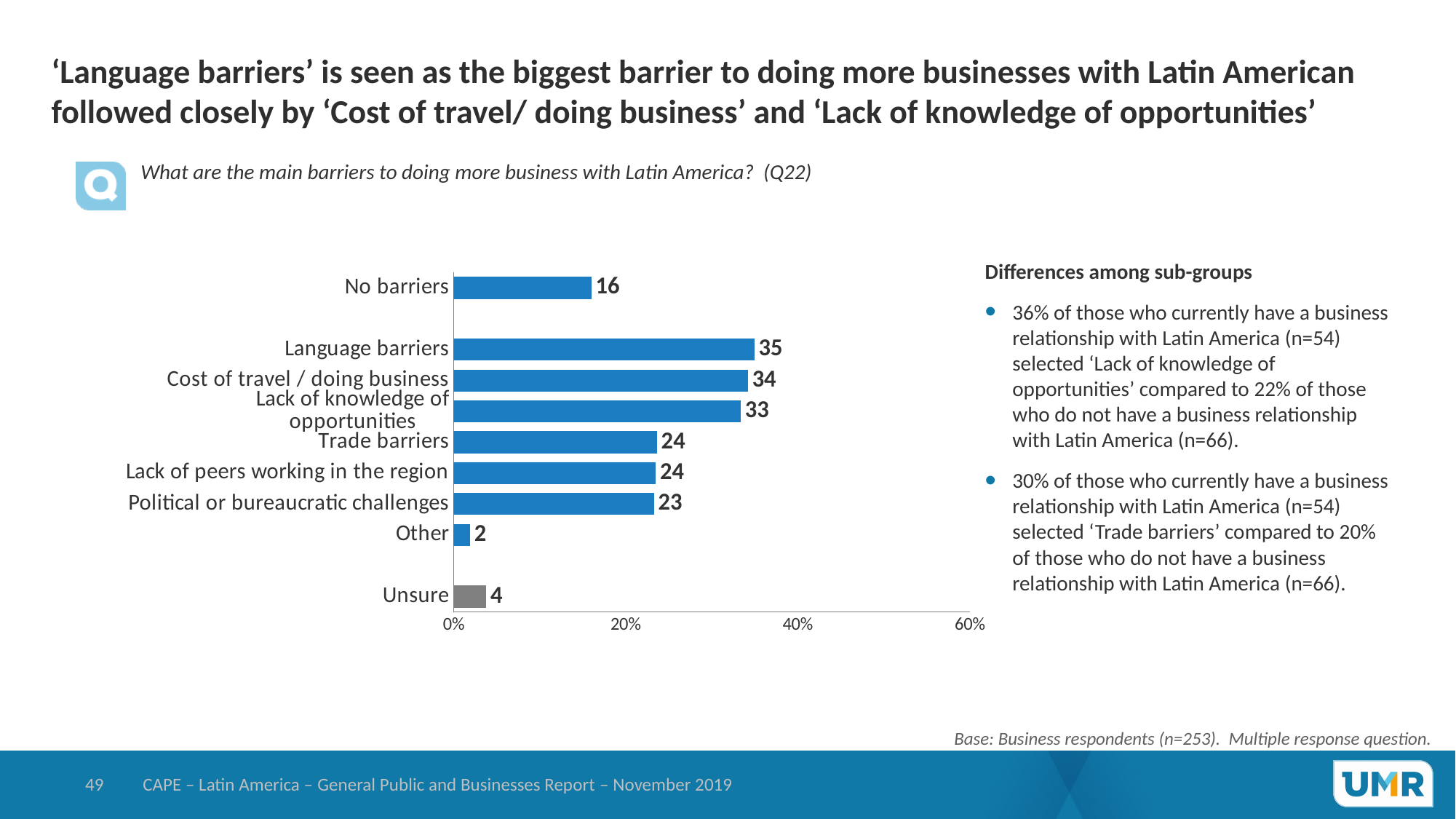
Which bar is shown in a different colour (grey) from the others? Unsure How many categories are shown in the chart? 9 Which is larger, the value for 'Cost of travel / doing business' or the value for 'Trade barriers'? Cost of travel / doing business Which category has the highest value? Language barriers Is the value for 'Language barriers' greater or less than 20%? greater What is the value for 'Political or bureaucratic challenges'? 23 What is the value for 'Unsure'? 4 What is the value for 'No barriers'? 16 What is the value for 'Language barriers'? 35 What is the difference between the values for 'Language barriers' and 'Lack of knowledge of opportunities'? 2 What kind of chart is shown on the slide? Bar chart Which category has the lowest value? Other